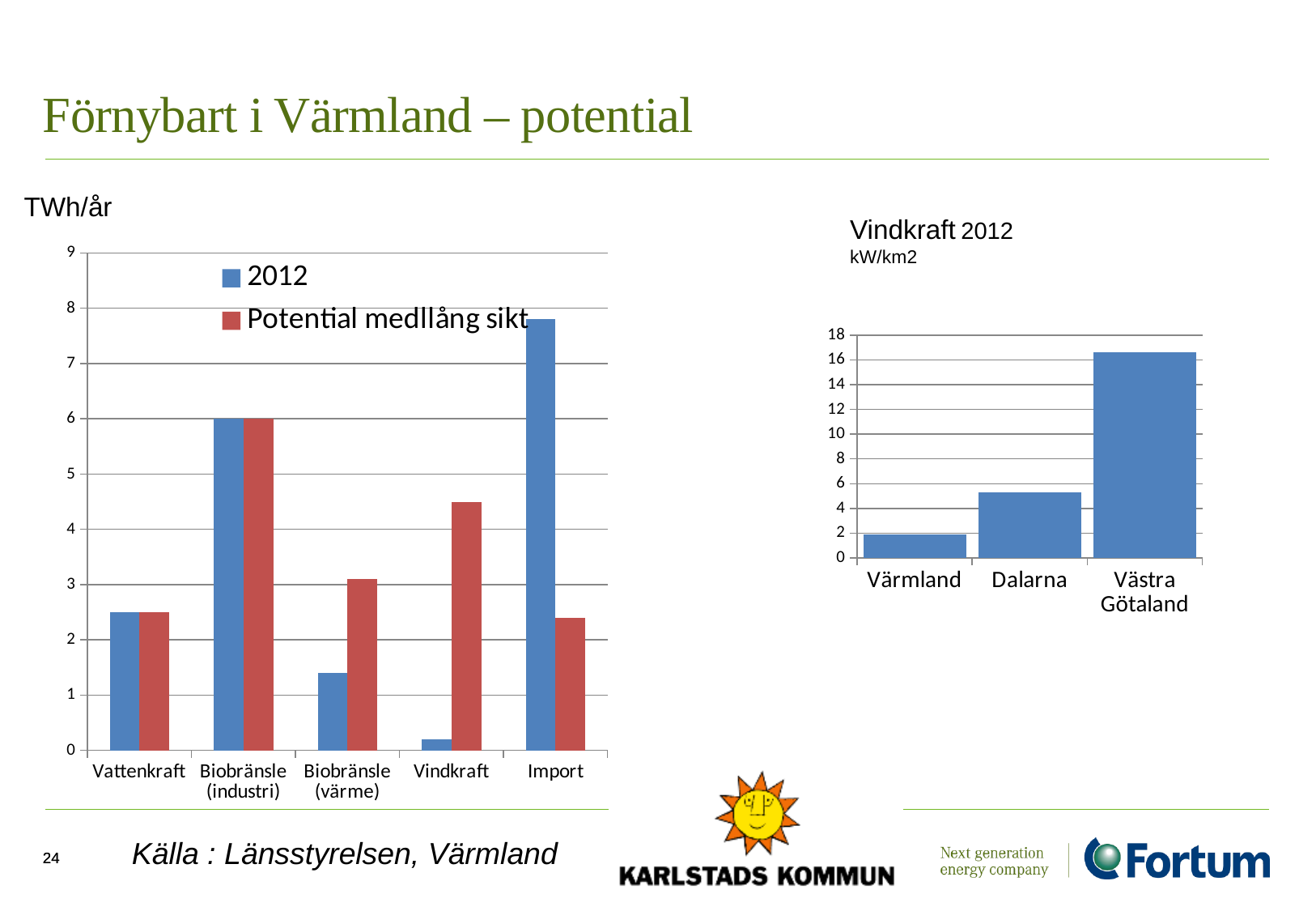
What are the two legend entries of the left chart (TWh/år)? 2012 and Potential medllång sikt In the Vindkraft 2012 chart, is the value for Dalarna greater or less than 4? greater How many categories are shown on the x axis of the left chart (TWh/år)? 5 In the left chart (TWh/år), which category has the highest value for Potential medllång sikt? Biobränsle (industri) In the left chart (TWh/år), is the 2012 value for Import greater or less than 7? greater What kind of chart is the left chart (TWh/år)? bar chart In the Vindkraft 2012 chart, which region has the highest value? Västra Götaland In the left chart (TWh/år), which category has the highest 2012 value? Import In the left chart (TWh/år), which category has the lowest 2012 value? Vindkraft How many series does the legend of the left chart (TWh/år) list? 2 In the left chart (TWh/år), what is the 2012 value for Biobränsle (industri)? 6 In the left chart (TWh/år), which is larger for Vindkraft: the 2012 value or the Potential medllång sikt value? Potential medllång sikt